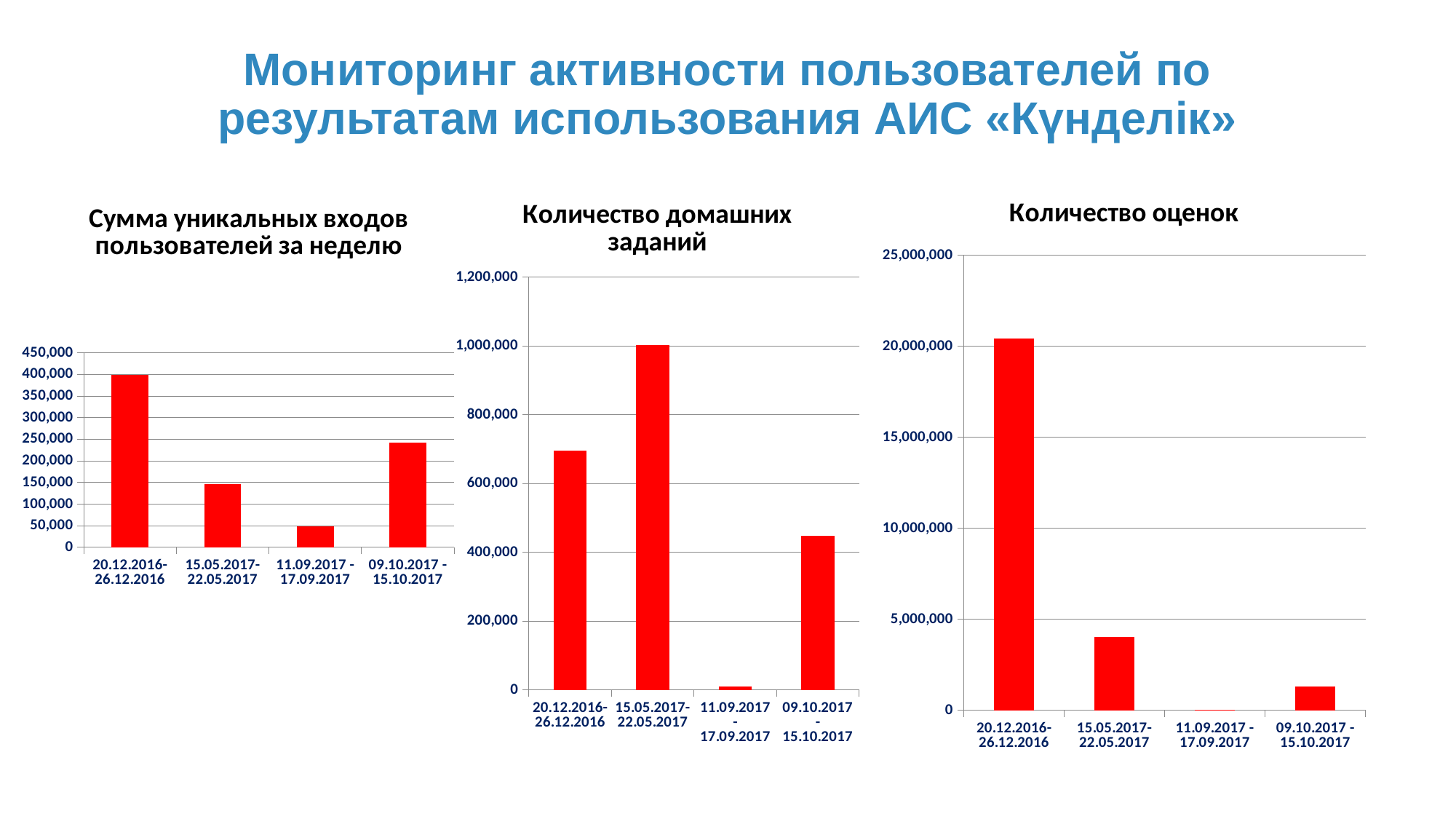
What kind of chart is the "Количество оценок" chart? bar chart What is the highest value shown on the y axis of the "Количество оценок" chart? 25,000,000 In the "Количество оценок" chart, is the value for 15.05.2017-22.05.2017 greater or less than 5,000,000? less In the "Количество домашних заданий" chart, which period has the lowest value? 11.09.2017 - 17.09.2017 In the "Количество домашних заданий" chart, which period has the highest value? 15.05.2017-22.05.2017 In the "Количество оценок" chart, which period has the highest value? 20.12.2016-26.12.2016 In the "Сумма уникальных входов пользователей за неделю" chart, which period has the highest value? 20.12.2016-26.12.2016 In the "Сумма уникальных входов пользователей за неделю" chart, which period has the lowest value? 11.09.2017 - 17.09.2017 How many categories are shown on the x axis of the "Сумма уникальных входов пользователей за неделю" chart? 4 In the "Количество домашних заданий" chart, which is larger: the value for 20.12.2016-26.12.2016 or the value for 09.10.2017 - 15.10.2017? 20.12.2016-26.12.2016 In the "Количество домашних заданий" chart, is the value for 20.12.2016-26.12.2016 greater or less than 600,000? greater In the "Сумма уникальных входов пользователей за неделю" chart, is the value for 09.10.2017 - 15.10.2017 greater or less than 200,000? greater